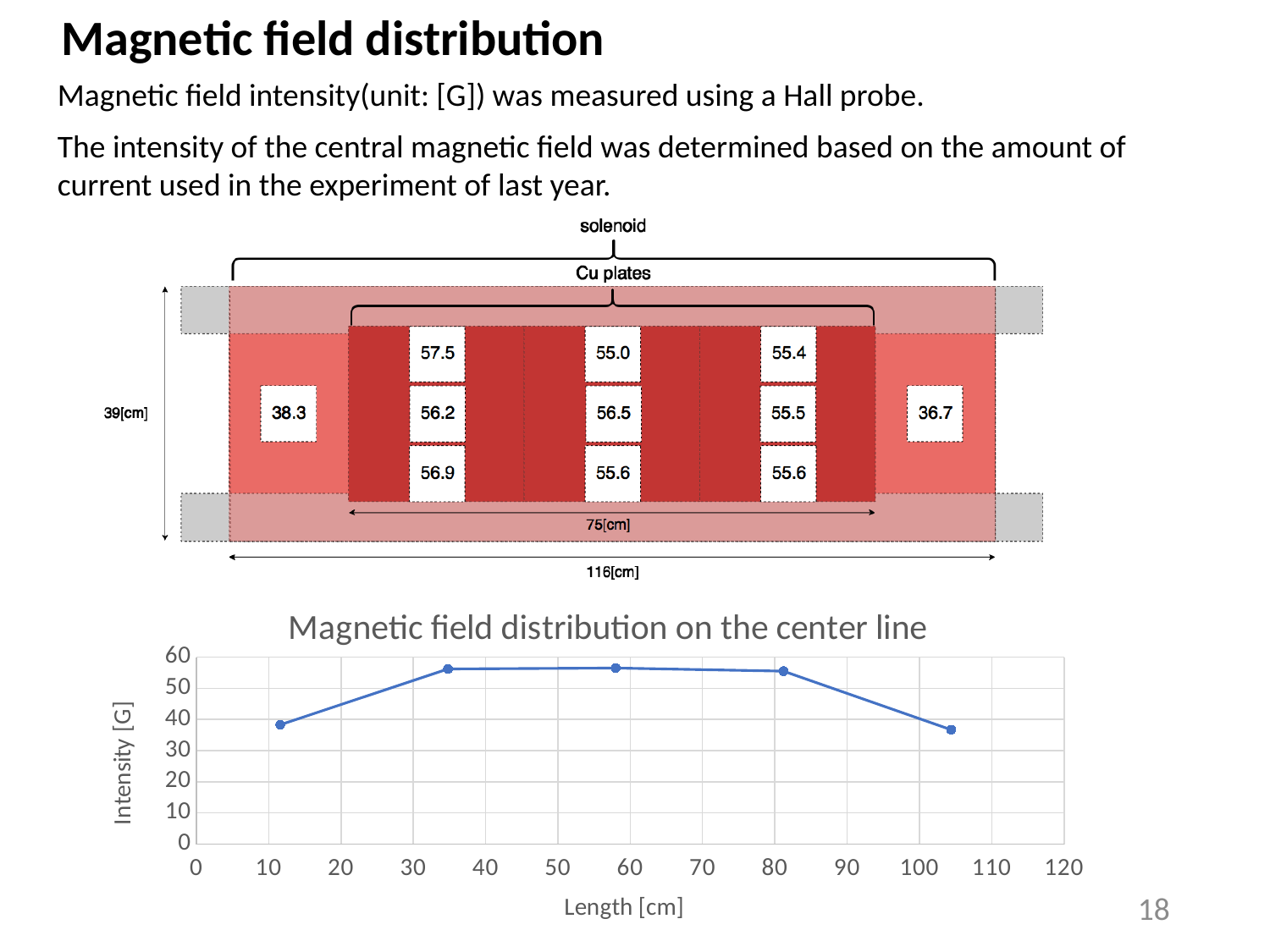
Is the value of the last (rightmost) data point greater or less than 40? less Is the value of the second data point (near 35 cm) greater or less than 60? less What is the label of the y axis of the chart? Intensity [G] Does the intensity rise or fall between the fourth and fifth data points? fall Is the value of the middle data point (near 60 cm) greater or less than 50? greater Which is larger: the value of the middle data point (near 60 cm) or the value of the last data point? the middle data point What kind of chart is shown on the slide? line chart What is the title of the chart on the slide? Magnetic field distribution on the center line Does the intensity rise or fall between the first and second data points? rise Which is larger: the value of the first data point or the value of the second data point? the second data point How many data points are plotted on the line chart? 5